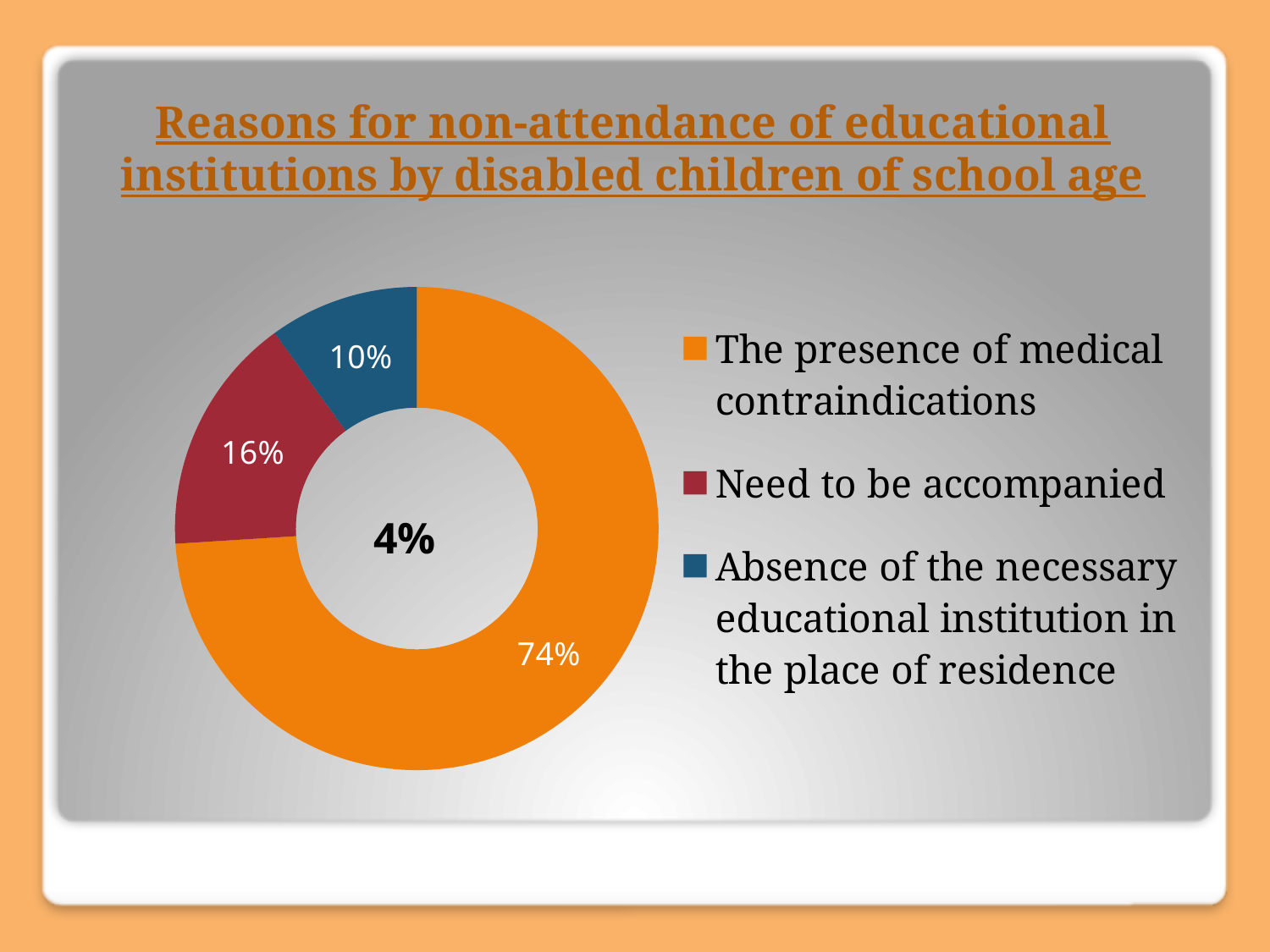
Which reason has the smallest share of the chart? Absence of the necessary educational institution in the place of residence What share of the chart is 'Need to be accompanied'? 16% What is the title of the slide? Reasons for non-attendance of educational institutions by disabled children of school age What share of the chart is 'The presence of medical contraindications'? 74% Which is larger: the share for 'Need to be accompanied' or the share for 'Absence of the necessary educational institution in the place of residence'? Need to be accompanied What share of the chart is 'Absence of the necessary educational institution in the place of residence'? 10% What colour is the slice for 'Need to be accompanied'? Red How many entries does the legend list? 3 What kind of chart is shown on the slide? Doughnut (pie) chart What is the difference in percentage points between 'Need to be accompanied' and 'Absence of the necessary educational institution in the place of residence'? 6 Which reason has the largest share of the chart? The presence of medical contraindications What is the difference in percentage points between 'The presence of medical contraindications' and 'Need to be accompanied'? 58